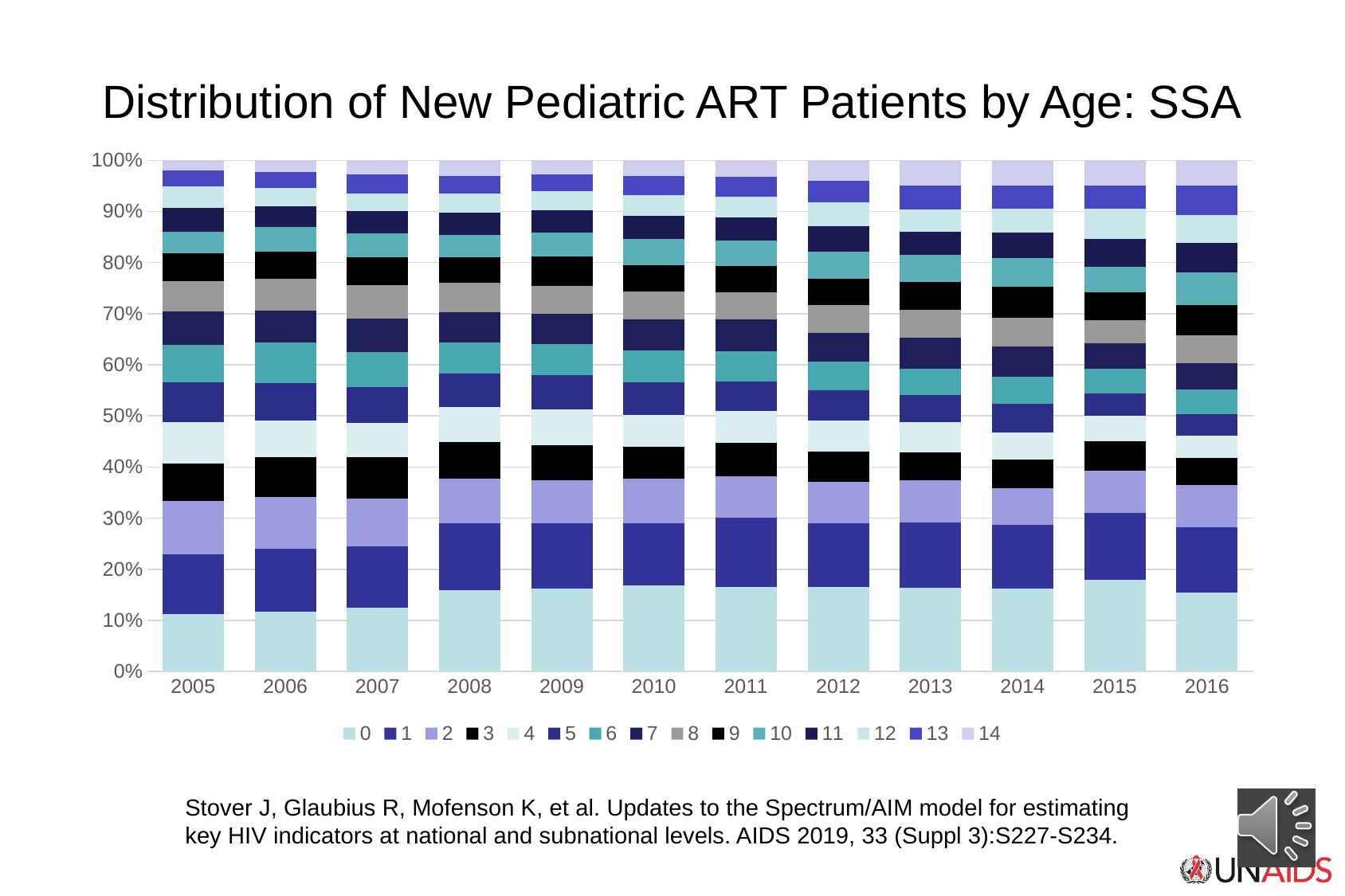
Which year has the larger share for age 0, 2005 or 2015? 2015 What is the first year shown on the x axis? 2005 Is the share for age 0 in 2005 greater or less than 20%? less How many years are shown along the x axis of the chart? 12 Which year has the larger share for age 14 (the top segment), 2005 or 2016? 2016 Is the share for age 0 in 2015 greater or less than 10%? greater What is the highest value shown on the y axis? 100% What is the title of the chart? Distribution of New Pediatric ART Patients by Age: SSA What is the last year shown on the x axis? 2016 What is the total of each stacked bar in the chart? 100% How many series does the legend list? 15 What kind of chart is shown on the slide? Stacked bar chart